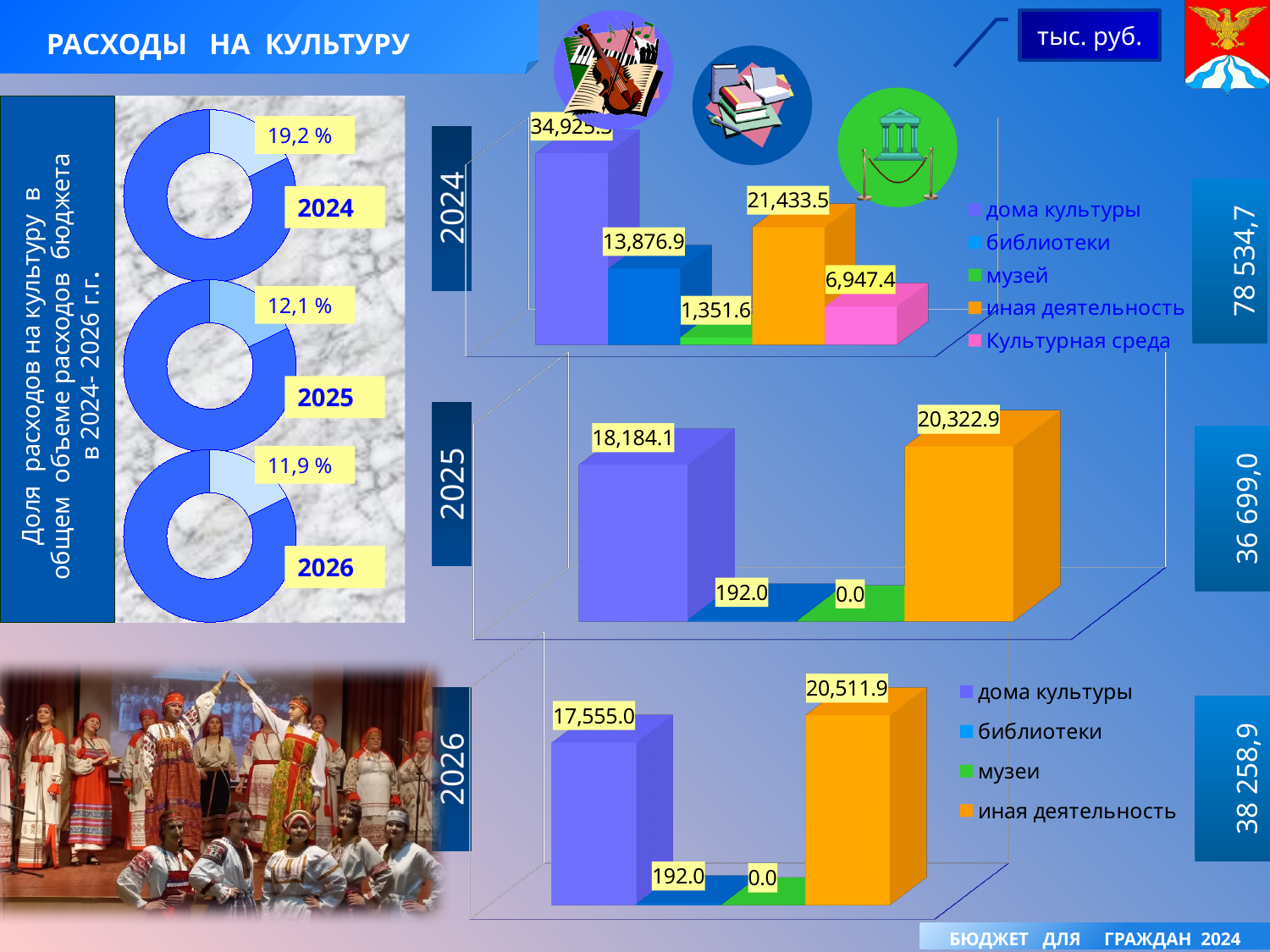
In the 2024 bar chart, what is the value for иная деятельность? 21,433.5 In the 2026 bar chart, what is the value for иная деятельность? 20,511.9 In the 2025 bar chart, what is the value for дома культуры? 18,184.1 In the 2025 bar chart, what is the difference between иная деятельность and дома культуры? 2,138.8 In the 2024 bar chart, what is the value for библиотеки? 13,876.9 In the 2024 bar chart, which category has the lowest value? музей In the 2026 bar chart, which is larger: дома культуры or иная деятельность? иная деятельность In the donut chart for 2024 on the left, what share is shown for the highlighted slice? 19,2 % How many series does the legend of the 2024 bar chart list? 5 In the 2024 bar chart, what is the value for Культурная среда? 6,947.4 How many series does the legend of the 2026 bar chart list? 4 In the 2025 bar chart, which category has the highest value? иная деятельность